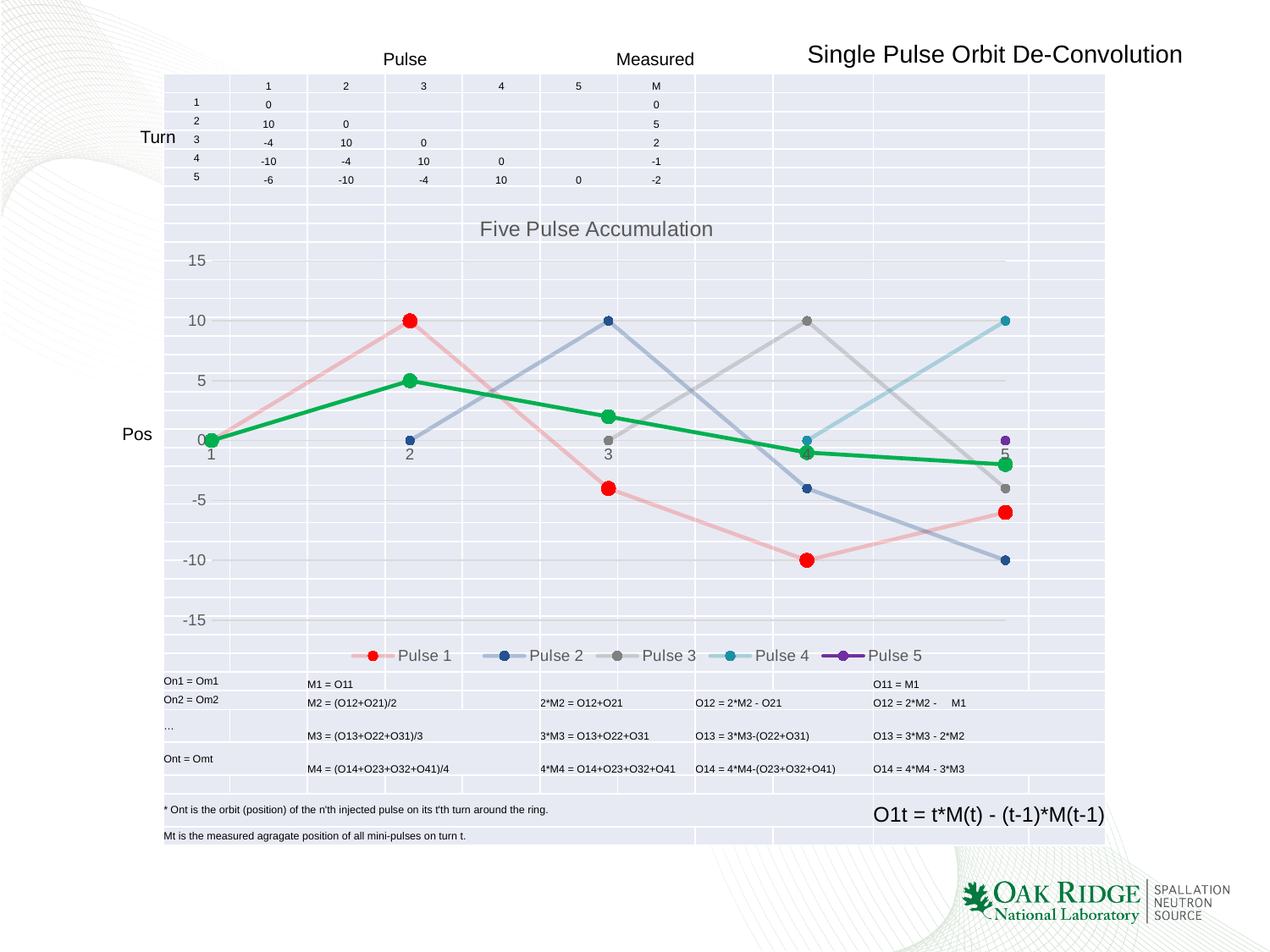
How many turns are shown along the x axis of the "Five Pulse Accumulation" chart? 5 In the "Five Pulse Accumulation" chart, which series has the highest value at turn 3? Pulse 2 In the "Five Pulse Accumulation" chart, what is the value of Pulse 2 at turn 5? -10 How many series does the legend of the "Five Pulse Accumulation" chart list? 5 What kind of chart is the "Five Pulse Accumulation" chart? line chart In the "Five Pulse Accumulation" chart, does Pulse 1 rise or fall from turn 2 to turn 4? fall In the "Five Pulse Accumulation" chart, what is the value of Pulse 4 at turn 5? 10 In the "Five Pulse Accumulation" chart, what is the value of Pulse 1 at turn 4? -10 In the "Five Pulse Accumulation" chart, what is the value of Pulse 1 at turn 2? 10 In the "Five Pulse Accumulation" chart, what is the difference between Pulse 1 at turn 2 and Pulse 1 at turn 4? 20 In the "Five Pulse Accumulation" chart, at turn 5, which is larger: Pulse 4 or Pulse 2? Pulse 4 In the "Five Pulse Accumulation" chart, which series has the lowest value at turn 4? Pulse 1